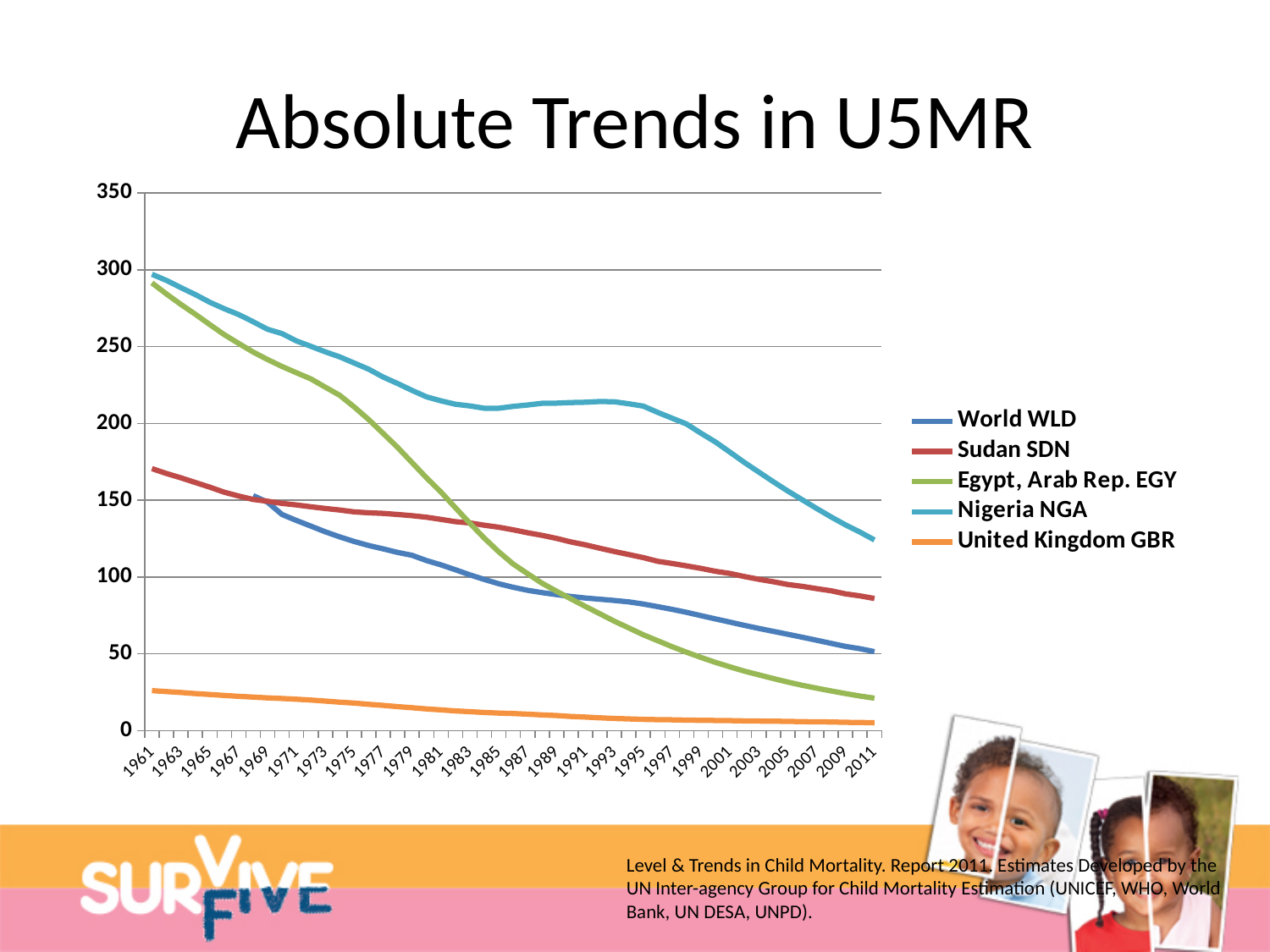
Which series is drawn in orange? United Kingdom GBR How many series does the legend list? 5 In 2011, which is larger: the value for Sudan SDN or the value for Egypt, Arab Rep. EGY? Sudan SDN Which series has the lowest values across the whole period? United Kingdom GBR What kind of chart is shown on the slide? line chart Which series has the highest value in 2011? Nigeria NGA What is the title of the chart? Absolute Trends in U5MR Is the value for Egypt, Arab Rep. EGY in 2011 greater or less than 50? less Is the value for Nigeria NGA in 1961 greater or less than 250? greater Is the value for World WLD in 2011 greater or less than 100? less Which series drops below the World WLD line around 1991? Egypt, Arab Rep. EGY Does the Nigeria NGA line rise or fall from 1961 to 2011? fall